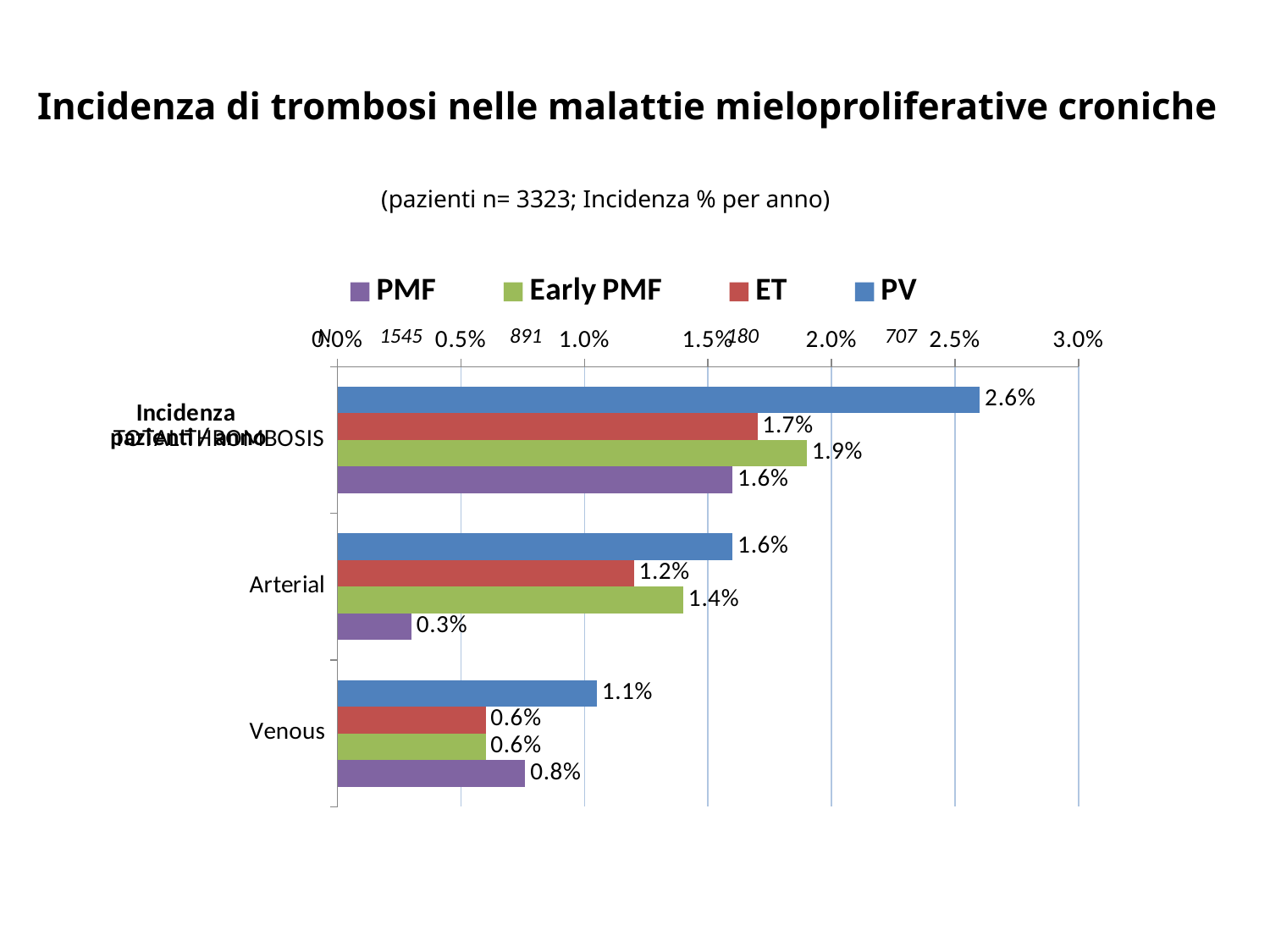
What type of chart is shown on the slide? bar chart In the Venous category, which is larger: the PMF value or the ET value? PMF What is the value for PV in the Venous category? 1.1% Which series has the lowest value in the Arterial category? PMF What is the value for PV in the Arterial category? 1.6% What is the difference between the PV and ET values in the Venous category? 0.5% Which series is shown in blue in the legend? PV How many series does the legend list? 4 What is the difference between the Early PMF and ET values in the Arterial category? 0.2% Which series has the highest value in the Arterial category? PV What is the value for Early PMF in the Venous category? 0.6% What is the value for PMF in the Arterial category? 0.3%